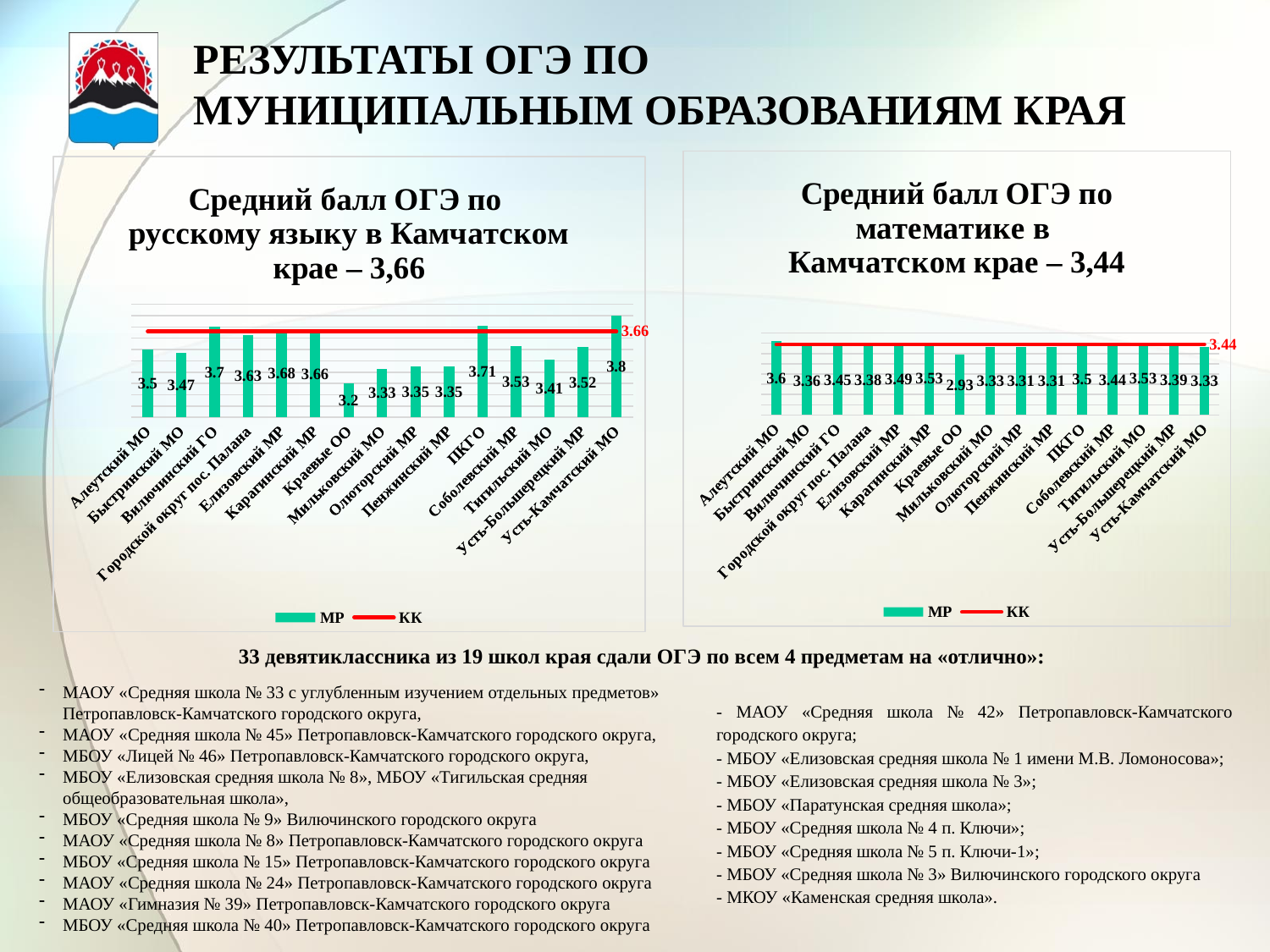
How many categories are shown on the x axis of the right chart (Средний балл ОГЭ по математике)? 15 In the right chart (Средний балл ОГЭ по математике), what is the difference between the values for Алеутский МО and Краевые ОО? 0.67 In the right chart (Средний балл ОГЭ по математике), what is the value for Краевые ОО? 2.93 In the left chart (Средний балл ОГЭ по русскому языку), what value does the КК line show? 3.66 In the right chart (Средний балл ОГЭ по математике), which is larger: the value for Елизовский МР or the value for Быстринский МО? Елизовский МР In the left chart (Средний балл ОГЭ по русскому языку), what is the difference between the values for ПКГО and Краевые ОО? 0.51 In the right chart (Средний балл ОГЭ по математике), which category has the highest value? Алеутский МО In the left chart (Средний балл ОГЭ по русскому языку), which category has the highest value? Усть-Камчатский МО In the left chart (Средний балл ОГЭ по русскому языку), which category has the lowest value? Краевые ОО What kind of chart is the left chart (Средний балл ОГЭ по русскому языку)? Bar chart with a line How many series does the legend of the left chart (Средний балл ОГЭ по русскому языку) list? 2 In the left chart (Средний балл ОГЭ по русскому языку), what is the value for Усть-Камчатский МО? 3.8